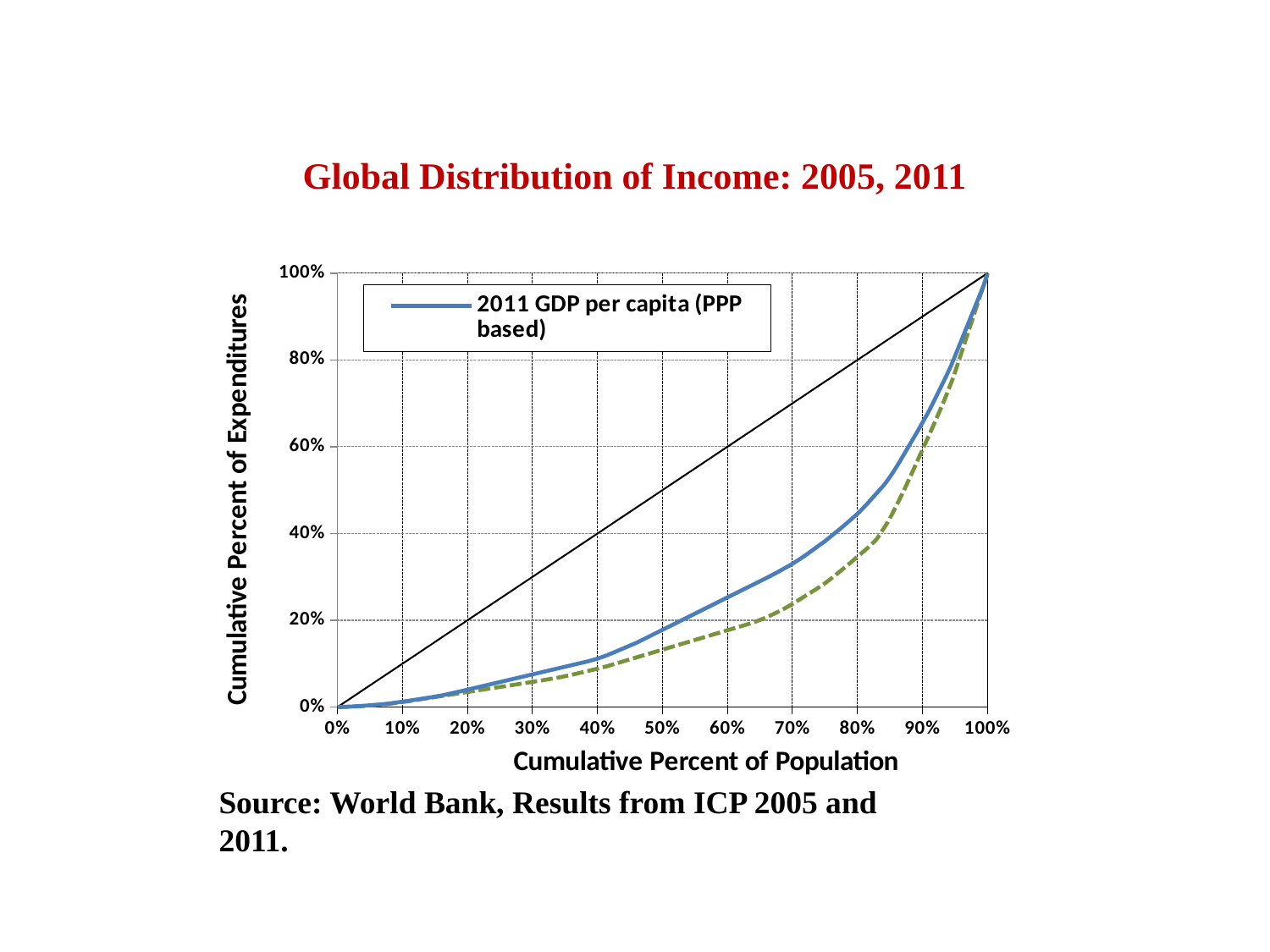
What is the value of the 2011 GDP per capita (PPP based) line at 0% cumulative percent of population? 0% What kind of chart is shown on the slide? line chart How many series does the chart's legend list? 1 What is the value of the 2011 GDP per capita (PPP based) line at 100% cumulative percent of population? 100% Is the value of the green dashed line at 80% cumulative percent of population greater or less than 40%? less Is the value of the 2011 GDP per capita (PPP based) line at 40% cumulative percent of population greater or less than 20%? less Is the value of the 2011 GDP per capita (PPP based) line at 60% cumulative percent of population greater or less than 20%? greater Does the 2011 GDP per capita (PPP based) line rise or fall as cumulative percent of population increases? rise At 80% cumulative percent of population, which is higher: the solid blue 2011 GDP per capita line or the green dashed line? the solid blue 2011 GDP per capita line What is the label of the series listed in the legend? 2011 GDP per capita (PPP based) What is the title of the chart on the slide? Global Distribution of Income: 2005, 2011